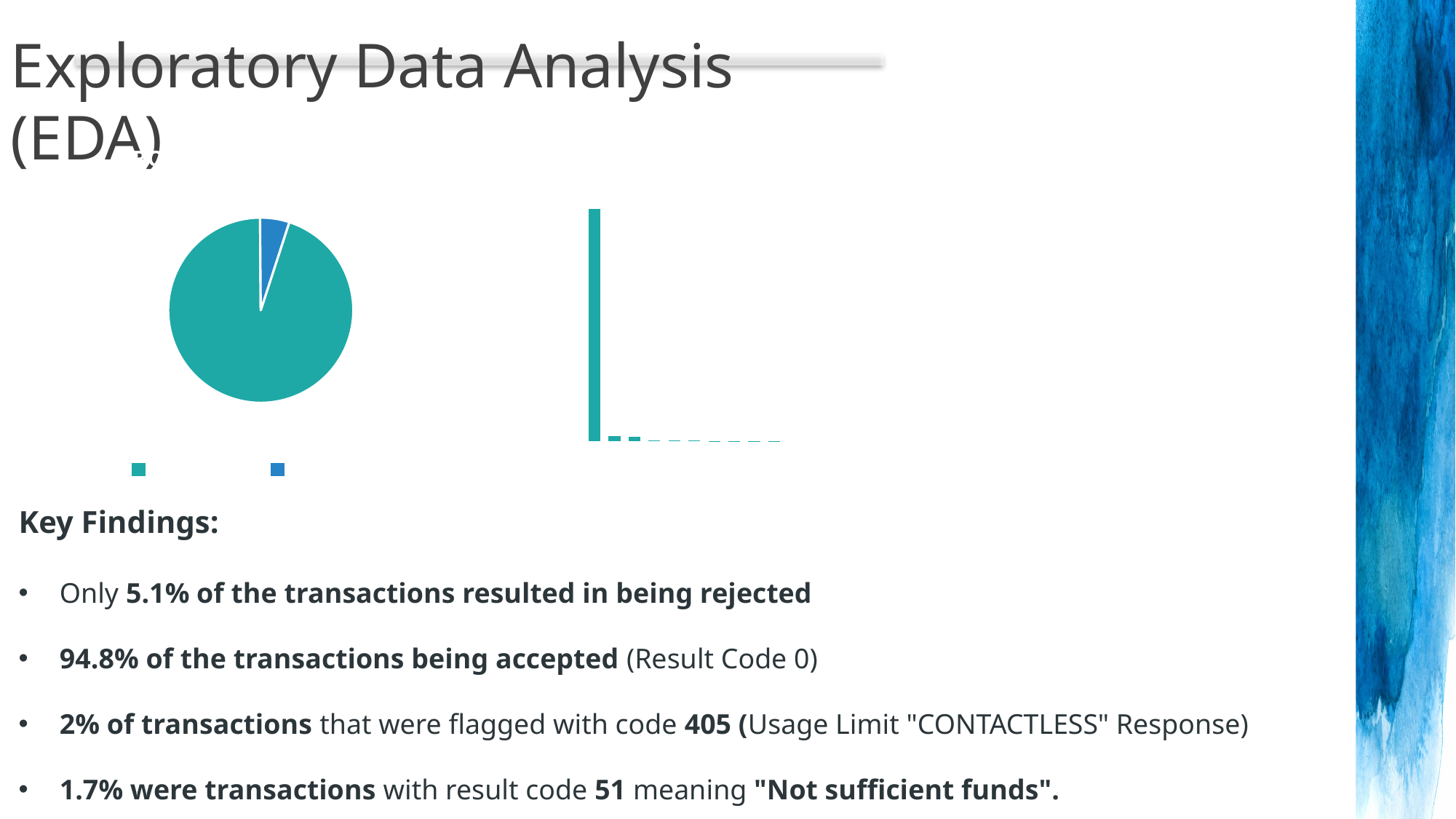
How many slices does the pie chart on the left have? 2 What kind of chart is the chart on the right of the slide? bar chart What colour is the largest slice of the pie chart on the left? teal In the bar chart on the right, do the bar heights rise or fall from left to right? fall In the bar chart on the right, which bar is the tallest? the leftmost (first) bar How many entries does the legend of the pie chart on the left show? 2 In the pie chart on the left, which slice is larger, the teal one or the blue one? the teal one What kind of chart is the chart on the left of the slide? pie chart